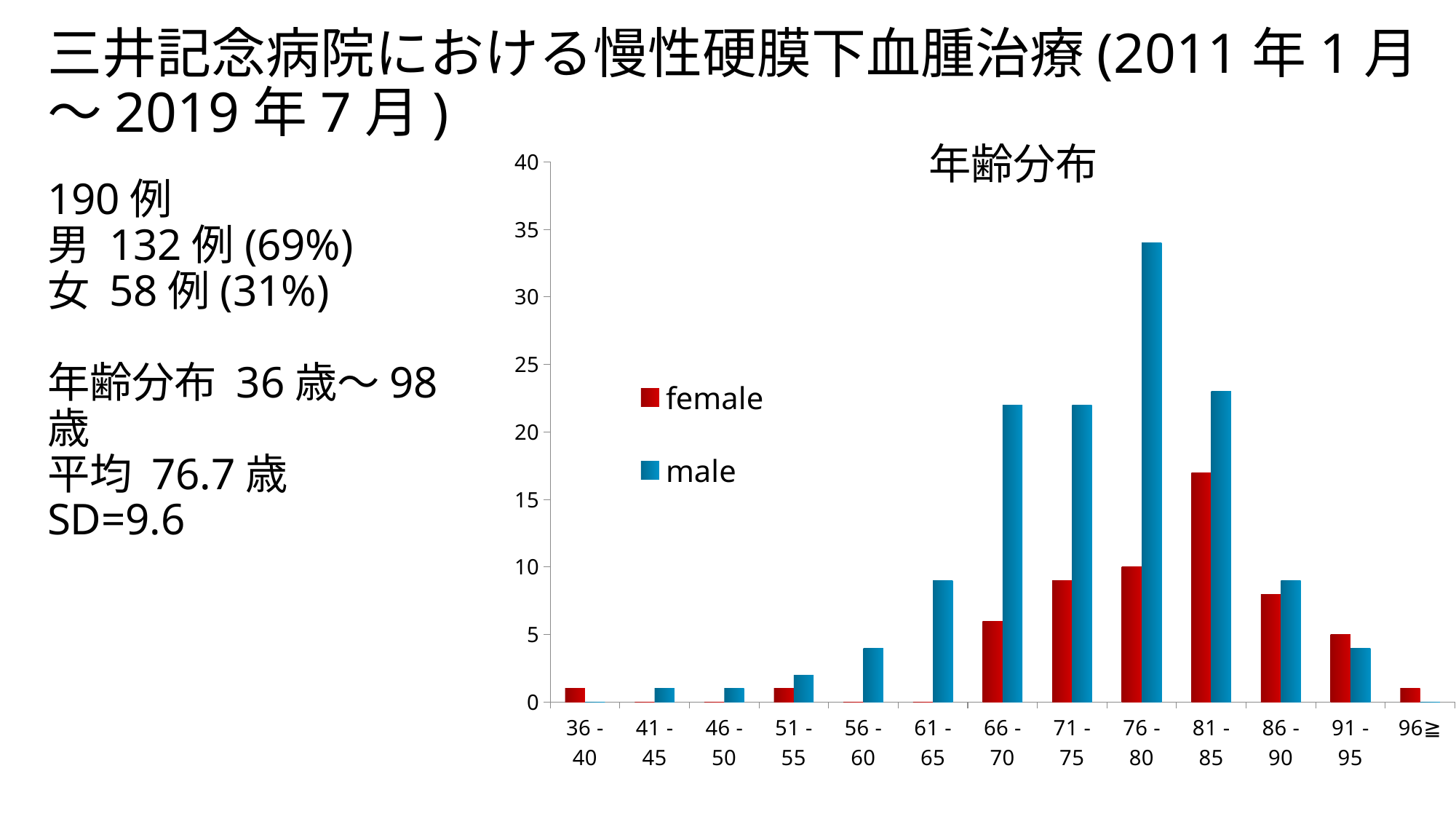
Which is larger for the 76 - 80 age category, the male value or the female value? male How many age categories are shown on the x axis of the chart? 13 What is the title of the chart? 年齢分布 Is the female value for 81 - 85 greater or less than 15? greater Which colour represents the male series in the chart? blue In which age category is the male value highest? 76 - 80 How many series does the chart legend list? 2 In which age category is the female value highest? 81 - 85 Do the male values rise or fall from the 56 - 60 category to the 76 - 80 category? rise Is the male value for 66 - 70 greater or less than 20? greater Is the male value for 76 - 80 greater or less than 30? greater What kind of chart is shown on the slide? bar chart